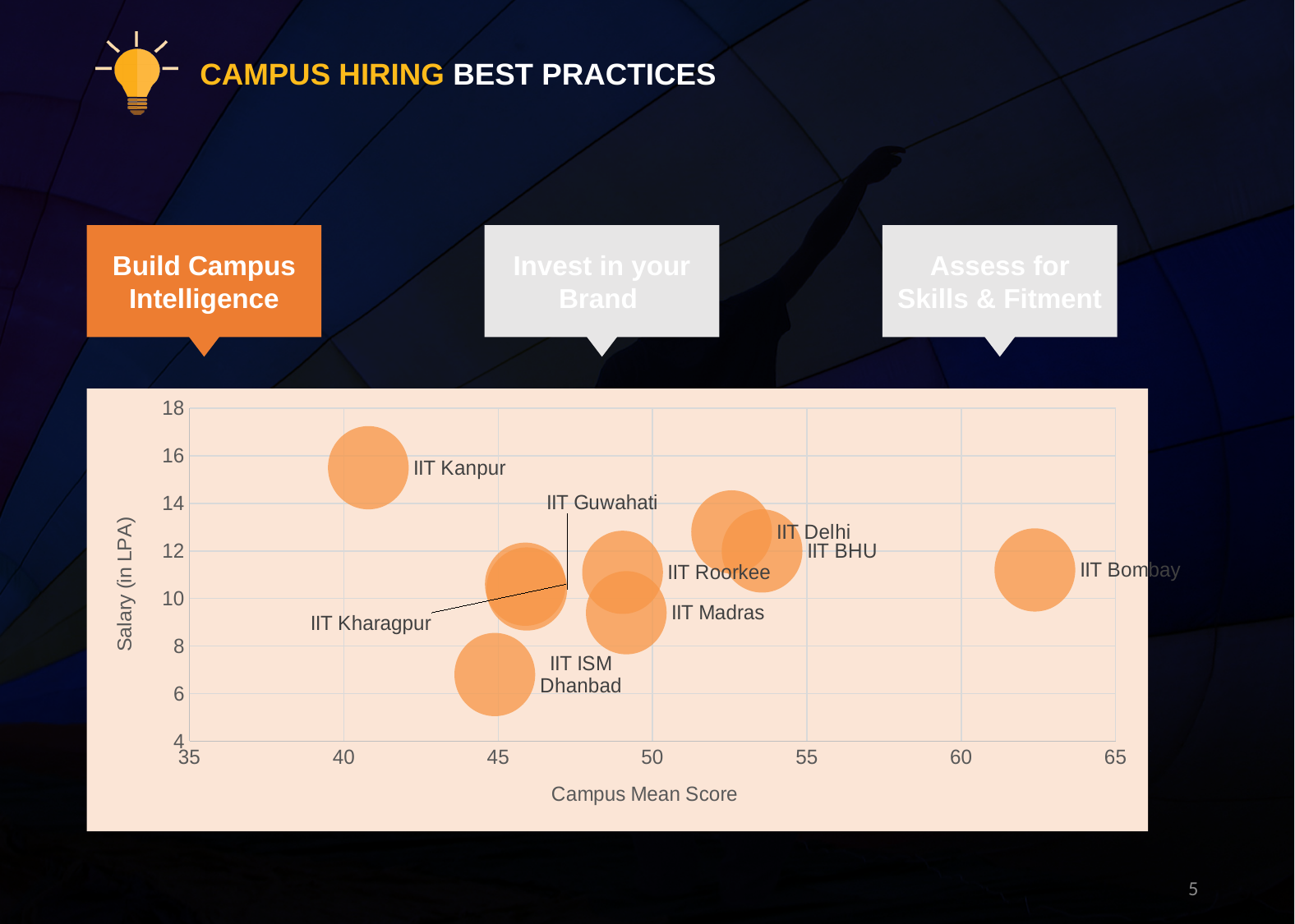
Is the Campus Mean Score for IIT Bombay greater or less than 60? greater Is the salary for IIT ISM Dhanbad greater or less than 8? less Which campus has the lowest Campus Mean Score in the chart? IIT Kanpur Which has the higher salary, IIT Kanpur or IIT ISM Dhanbad? IIT Kanpur What is the title of the y axis of the chart? Salary (in LPA) Which campus has the highest Campus Mean Score in the chart? IIT Bombay What is the title of the x axis of the chart? Campus Mean Score Which campus has the lowest salary (in LPA) in the chart? IIT ISM Dhanbad Which campus has the highest salary (in LPA) in the chart? IIT Kanpur Is the Campus Mean Score for IIT Delhi greater or less than 50? greater What kind of chart is shown on the slide? Bubble chart